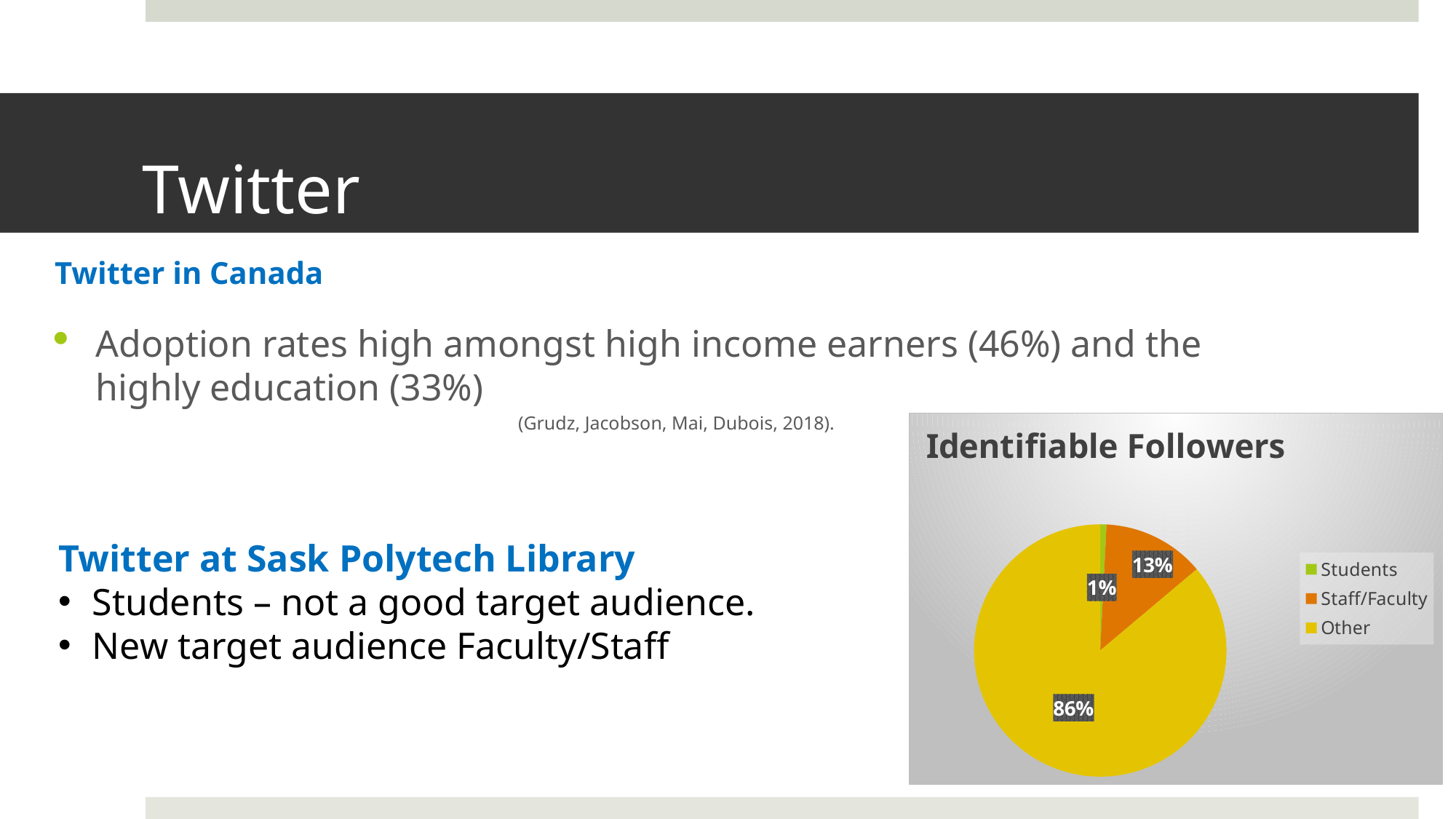
What type of chart is shown on the slide? pie chart What share of identifiable followers is Staff/Faculty? 13% Which category has the largest slice of the pie? Other What share of identifiable followers is Students? 1% What is the title of the chart? Identifiable Followers Which category has the smallest slice of the pie? Students What share of identifiable followers is Other? 86% What colour represents Staff/Faculty in the pie chart? orange Which is larger, the Staff/Faculty slice or the Students slice? Staff/Faculty How many categories does the pie chart show? 3 What is the difference in percentage points between Other and Staff/Faculty? 73 How many entries does the legend list? 3